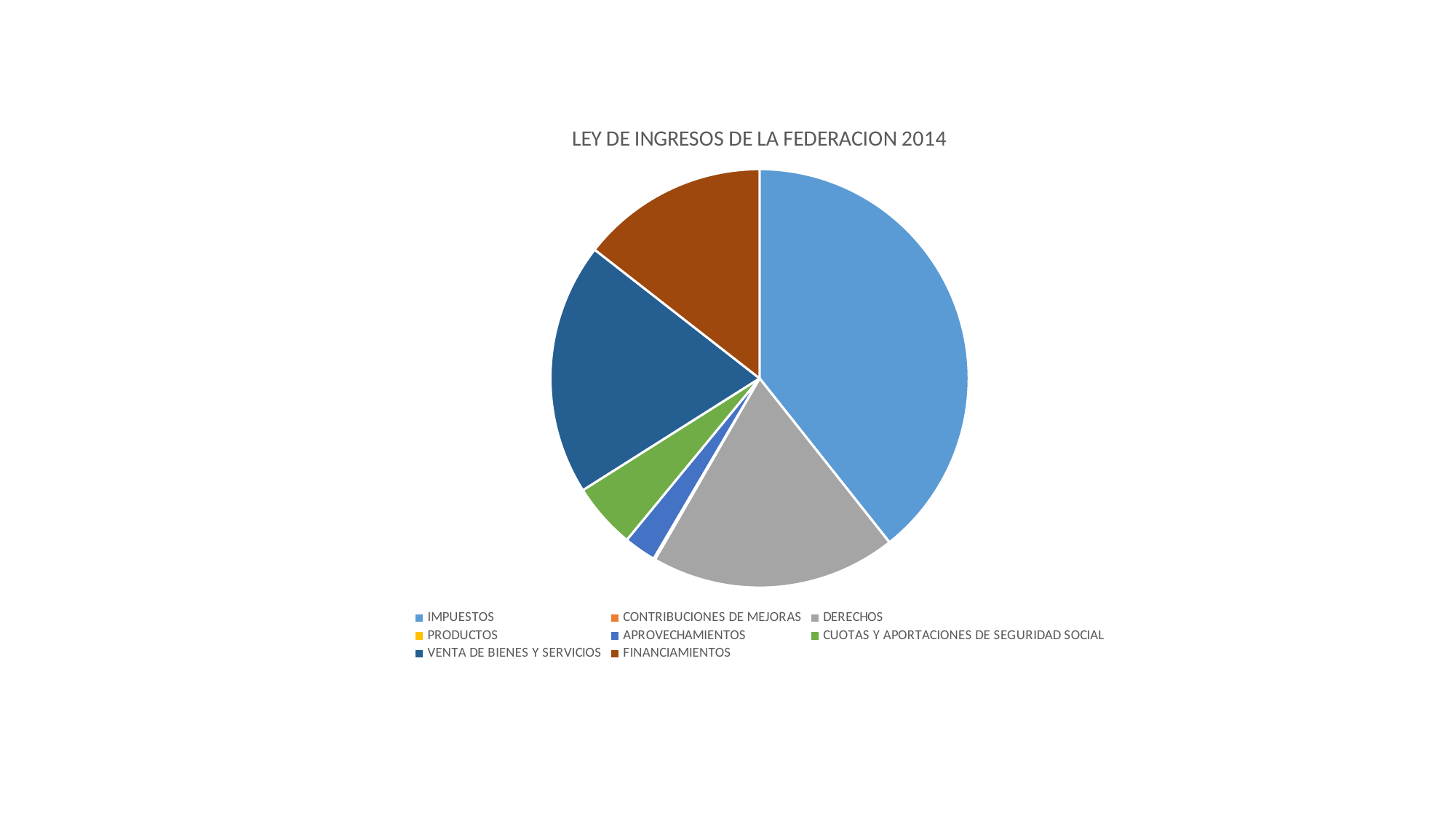
How many entries does the chart's legend list? 8 Which slice is larger, APROVECHAMIENTOS or CUOTAS Y APORTACIONES DE SEGURIDAD SOCIAL? CUOTAS Y APORTACIONES DE SEGURIDAD SOCIAL Which slice is larger, FINANCIAMIENTOS or APROVECHAMIENTOS? FINANCIAMIENTOS What kind of chart is shown on the slide? pie chart Which slice is larger, VENTA DE BIENES Y SERVICIOS or CUOTAS Y APORTACIONES DE SEGURIDAD SOCIAL? VENTA DE BIENES Y SERVICIOS Which category is shown in green in the legend? CUOTAS Y APORTACIONES DE SEGURIDAD SOCIAL What is the title of the chart? LEY DE INGRESOS DE LA FEDERACION 2014 Which category has the largest slice of the pie? IMPUESTOS